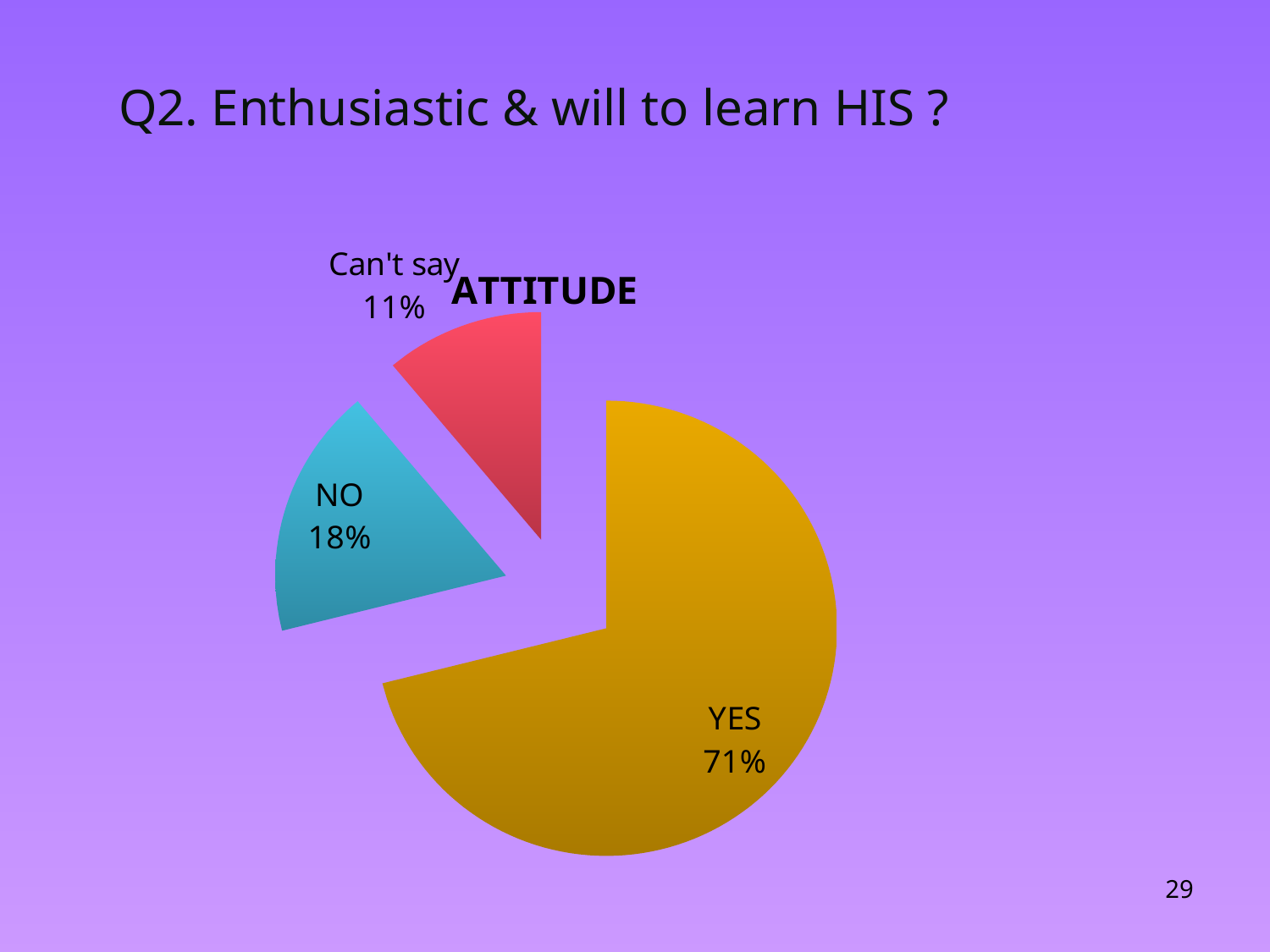
What is the difference in percentage points between the NO and Can't say slices? 7 What percentage of the pie is the Can't say slice? 11% What colour is the YES slice? gold/orange What percentage of the pie is the YES slice? 71% How many slices does the pie chart have? 3 What percentage of the pie is the NO slice? 18% What type of chart is shown on the slide? pie chart Which slice of the pie is the largest? YES Which slice of the pie is the smallest? Can't say Which slice is larger, NO or Can't say? NO What is the title of the chart? ATTITUDE What is the difference in percentage points between the YES and NO slices? 53